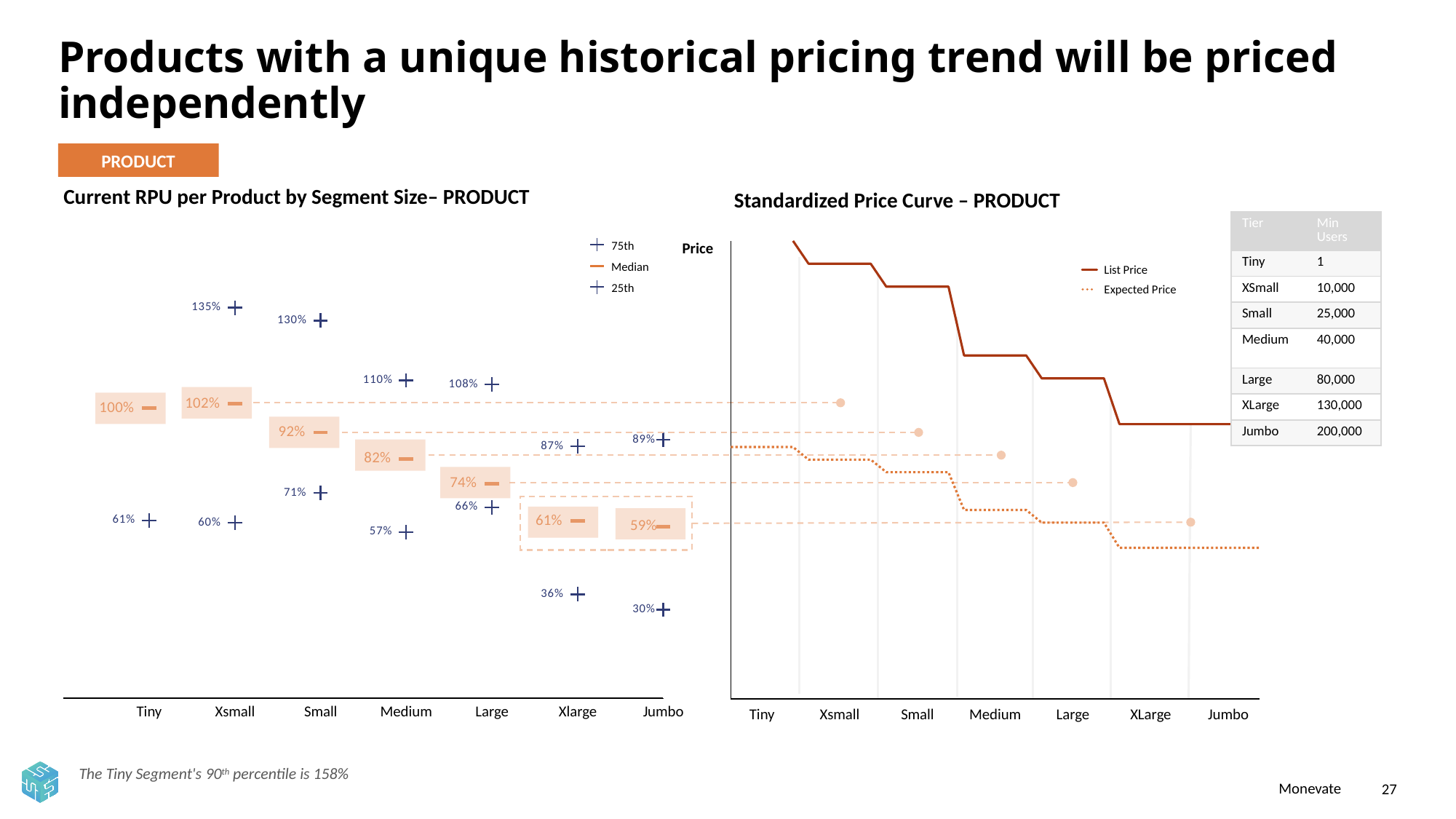
In the 'Current RPU per Product by Segment Size' chart, which segment has the lowest 25th percentile value? Jumbo How many series does the legend of the 'Standardized Price Curve' chart list? 2 In the 'Standardized Price Curve' chart, does the List Price line rise or fall from Tiny to Jumbo? Fall In the 'Current RPU per Product by Segment Size' chart, what is the Median value for the Small segment? 92% In the 'Current RPU per Product by Segment Size' chart, which segment has the highest Median value? Xsmall In the 'Current RPU per Product by Segment Size' chart, what is the difference between the 75th and 25th percentile values for the Medium segment? 53 percentage points What kind of chart is the 'Standardized Price Curve – PRODUCT' chart? Line chart How many series does the legend of the 'Current RPU per Product by Segment Size' chart list? 3 In the 'Current RPU per Product by Segment Size' chart, which has the larger Median value, Large or Xlarge? Large How many segment categories are shown on the x axis of the 'Current RPU per Product by Segment Size' chart? 7 In the 'Current RPU per Product by Segment Size' chart, what is the 25th percentile value for the Jumbo segment? 30% In the 'Current RPU per Product by Segment Size' chart, what is the 75th percentile value for the Xsmall segment? 135%